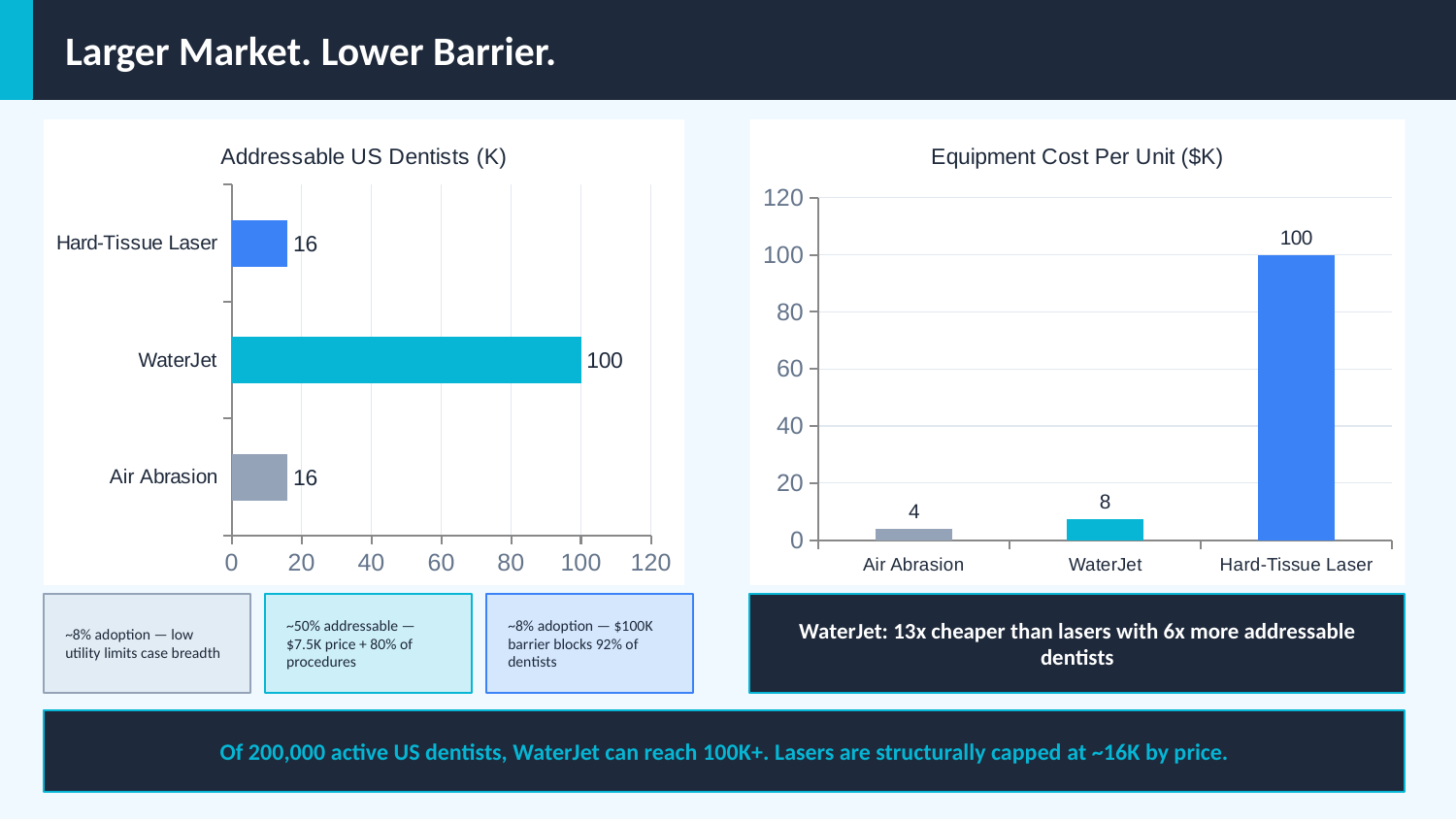
In the 'Addressable US Dentists (K)' chart, what is the difference between WaterJet and Hard-Tissue Laser? 84 In the 'Addressable US Dentists (K)' chart, how many categories are shown? 3 In the 'Addressable US Dentists (K)' chart, which category has the highest value? WaterJet In the 'Equipment Cost Per Unit ($K)' chart, is the value for WaterJet greater or less than Air Abrasion? greater In the 'Addressable US Dentists (K)' chart, what is the value for WaterJet? 100 In the 'Equipment Cost Per Unit ($K)' chart, what is the value for WaterJet? 8 In the 'Equipment Cost Per Unit ($K)' chart, is the value for Hard-Tissue Laser greater or less than 80? greater In the 'Equipment Cost Per Unit ($K)' chart, which category has the lowest value? Air Abrasion In the 'Equipment Cost Per Unit ($K)' chart, what is the difference between Hard-Tissue Laser and WaterJet? 92 In the 'Equipment Cost Per Unit ($K)' chart, what is the value for Hard-Tissue Laser? 100 In the 'Addressable US Dentists (K)' chart, what is the value for Air Abrasion? 16 What kind of chart is the 'Addressable US Dentists (K)' chart? Bar chart